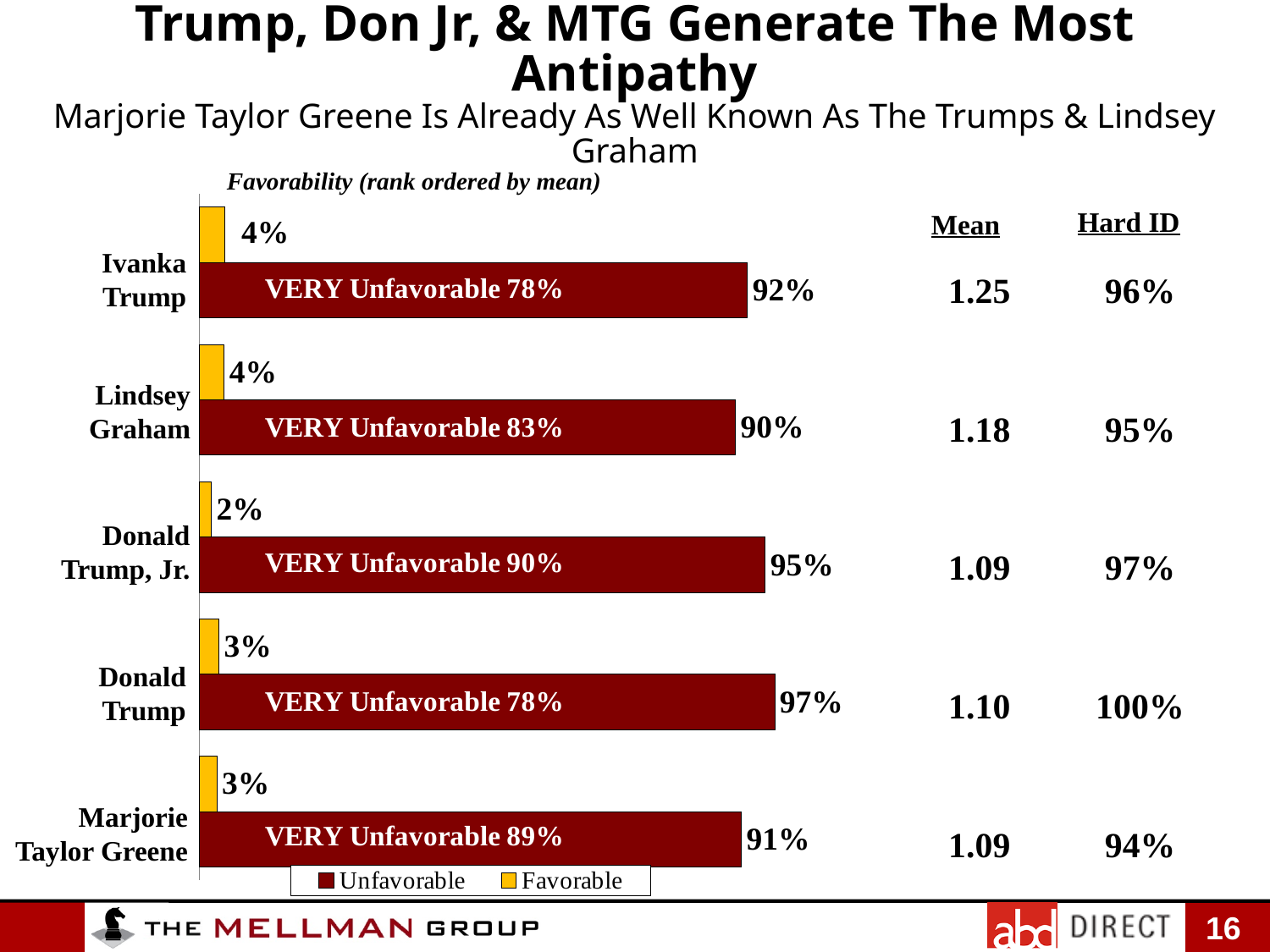
What is the Unfavorable value for Marjorie Taylor Greene? 91% What is the Favorable value for Donald Trump, Jr.? 2% How many series does the legend list? 2 What kind of chart is shown on the slide? Bar chart What is the Favorable value for Lindsey Graham? 4% Which person has the lowest Favorable value? Donald Trump, Jr. How many people are shown in the chart? 5 What is the VERY Unfavorable percentage printed on Donald Trump, Jr.'s bar? 90% What is the Unfavorable value for Donald Trump? 97% What is the difference between the Unfavorable values for Donald Trump and Lindsey Graham? 7% Which is larger, the Unfavorable value for Ivanka Trump or for Marjorie Taylor Greene? Ivanka Trump Which person has the highest Unfavorable value? Donald Trump